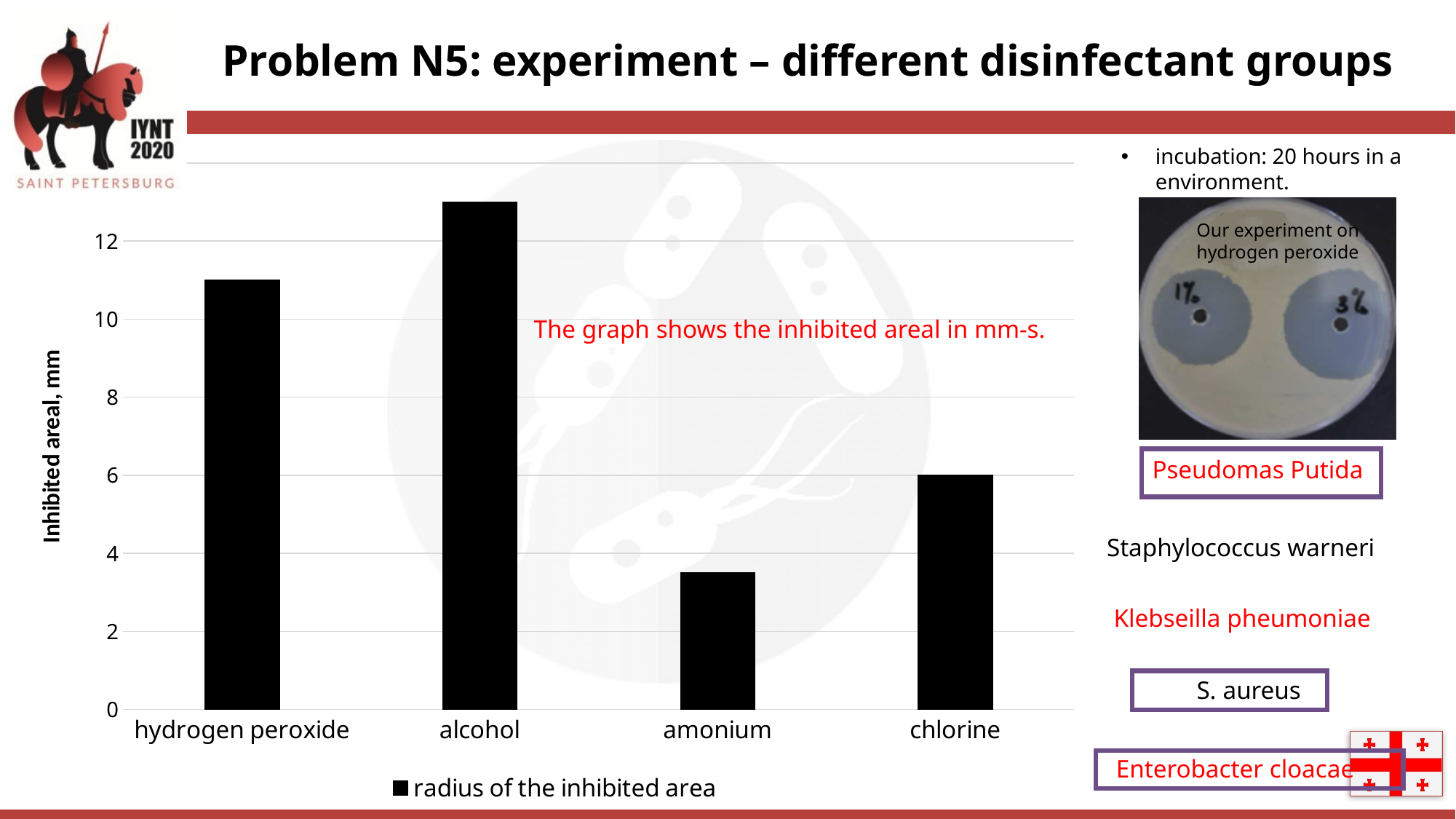
Which has a larger inhibited areal, amonium or chlorine? chlorine Is the value for amonium greater or less than 4? less Which disinfectant has the smallest inhibited areal? amonium Is the value for hydrogen peroxide greater or less than 10? greater What series name is shown in the legend? radius of the inhibited area What kind of chart is shown on the slide? bar chart What is the label of the y axis? Inhibited areal, mm Which has a larger inhibited areal, hydrogen peroxide or chlorine? hydrogen peroxide How many series does the legend list? 1 How many disinfectant categories are plotted on the x axis? 4 Is the value for alcohol greater or less than 12? greater Which disinfectant has the largest inhibited areal? alcohol